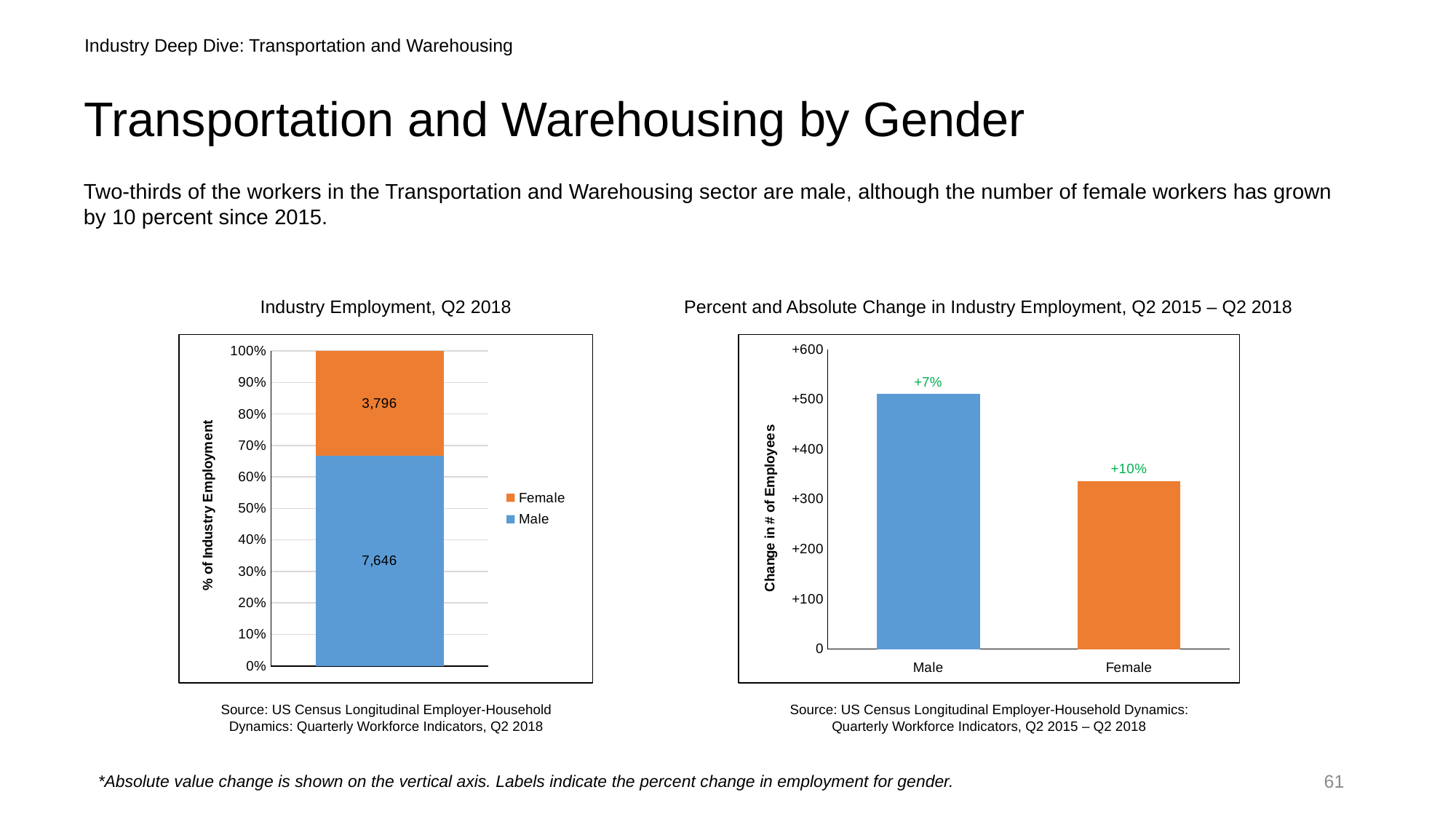
In the 'Industry Employment, Q2 2018' chart, how many series does the legend list? 2 In the 'Percent and Absolute Change in Industry Employment, Q2 2015 – Q2 2018' chart, is the bar for Female greater or less than +400? less In the 'Industry Employment, Q2 2018' chart, what is the label on the vertical axis? % of Industry Employment In the 'Percent and Absolute Change in Industry Employment, Q2 2015 – Q2 2018' chart, which gender has the taller bar? Male In the 'Industry Employment, Q2 2018' chart, which gender has the larger labelled value? Male In the 'Industry Employment, Q2 2018' chart, what is the difference between the Male and Female labelled values? 3,850 In the 'Industry Employment, Q2 2018' chart, what is the data label on the Female segment? 3,796 In the 'Percent and Absolute Change in Industry Employment, Q2 2015 – Q2 2018' chart, what percent change label is shown for Female? +10% In the 'Industry Employment, Q2 2018' chart, what is the data label on the Male segment? 7,646 In the 'Industry Employment, Q2 2018' chart, what is the total of the Male and Female labelled values? 11,442 What kind of chart is the 'Percent and Absolute Change in Industry Employment, Q2 2015 – Q2 2018' chart? Bar chart In the 'Percent and Absolute Change in Industry Employment, Q2 2015 – Q2 2018' chart, what percent change label is shown for Male? +7%